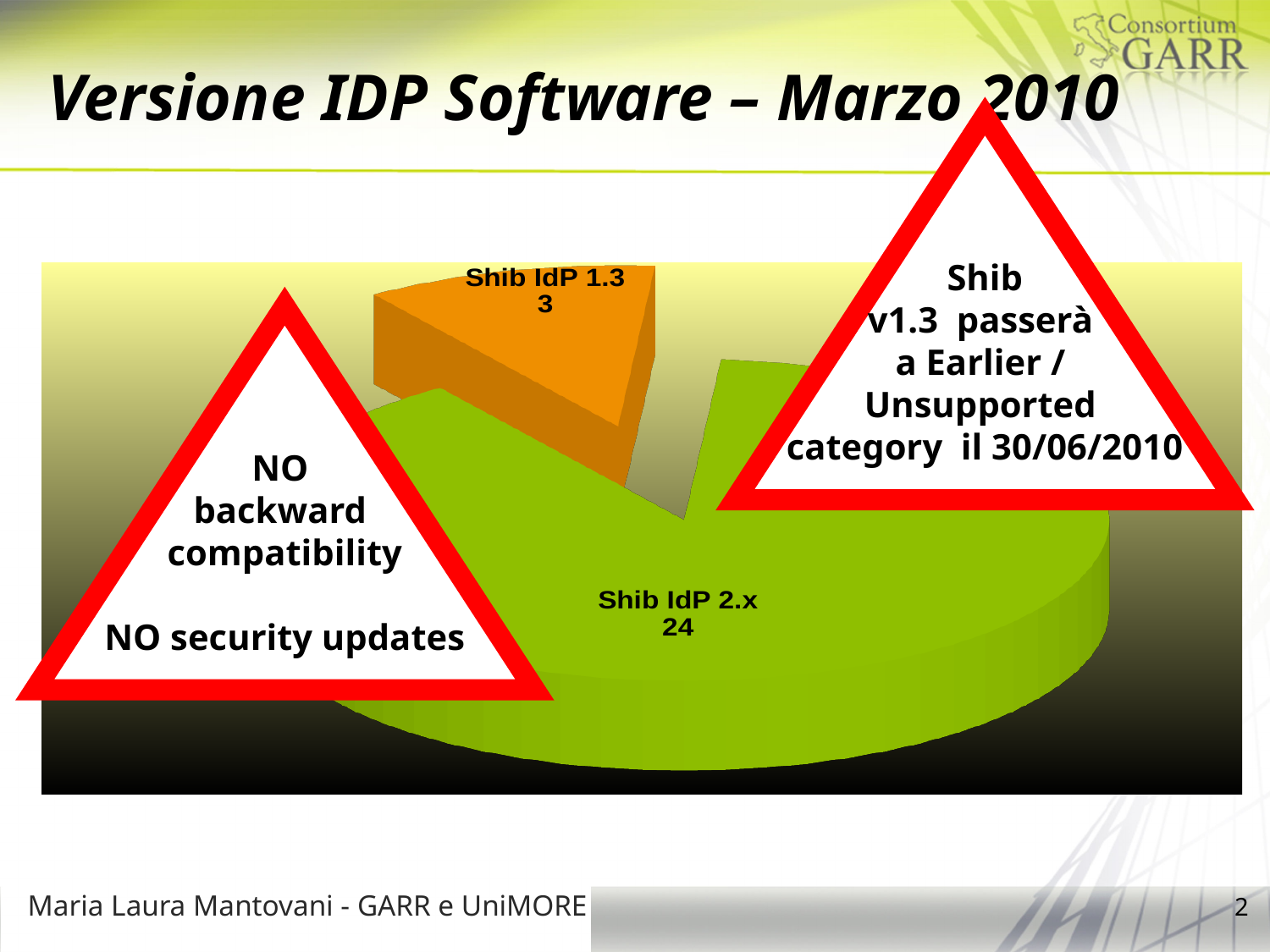
What is the title of the slide containing the chart? Versione IDP Software – Marzo 2010 How many slices does the pie chart have? 2 What is the difference between the values for Shib IdP 2.x and Shib IdP 1.3? 21 Which slice is the smallest? Shib IdP 1.3 What is the value for Shib IdP 2.x? 24 What is the total of all slices in the pie chart? 27 Which slice is the largest? Shib IdP 2.x What colour is the Shib IdP 1.3 slice? orange What kind of chart is shown on the slide? pie chart Which is larger, Shib IdP 1.3 or Shib IdP 2.x? Shib IdP 2.x What is the value for Shib IdP 1.3? 3